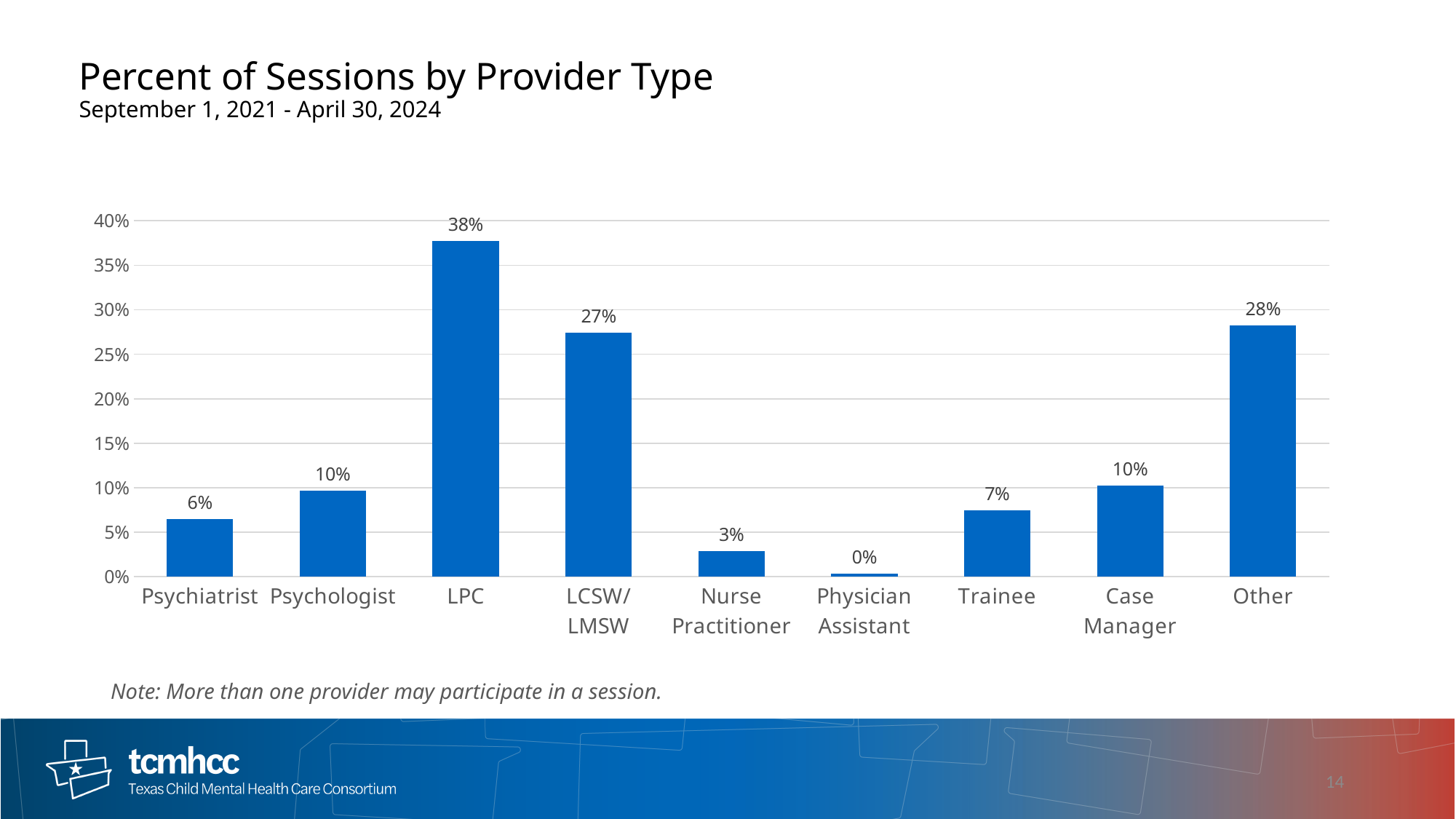
What kind of chart is shown on the slide? Bar chart Which provider type has the highest percent of sessions? LPC What percent of sessions involved an LPC? 38% What percent of sessions involved a Case Manager? 10% Is the value for Other greater or less than 25%? greater Which provider type has the lowest percent of sessions? Physician Assistant What is the title of the chart? Percent of Sessions by Provider Type What is the difference in percentage points between LPC and LCSW/LMSW? 11 How many provider types are shown on the chart? 9 Which has a higher percent of sessions, Psychiatrist or Trainee? Trainee What percent of sessions involved a Nurse Practitioner? 3% What date range does the chart cover? September 1, 2021 - April 30, 2024